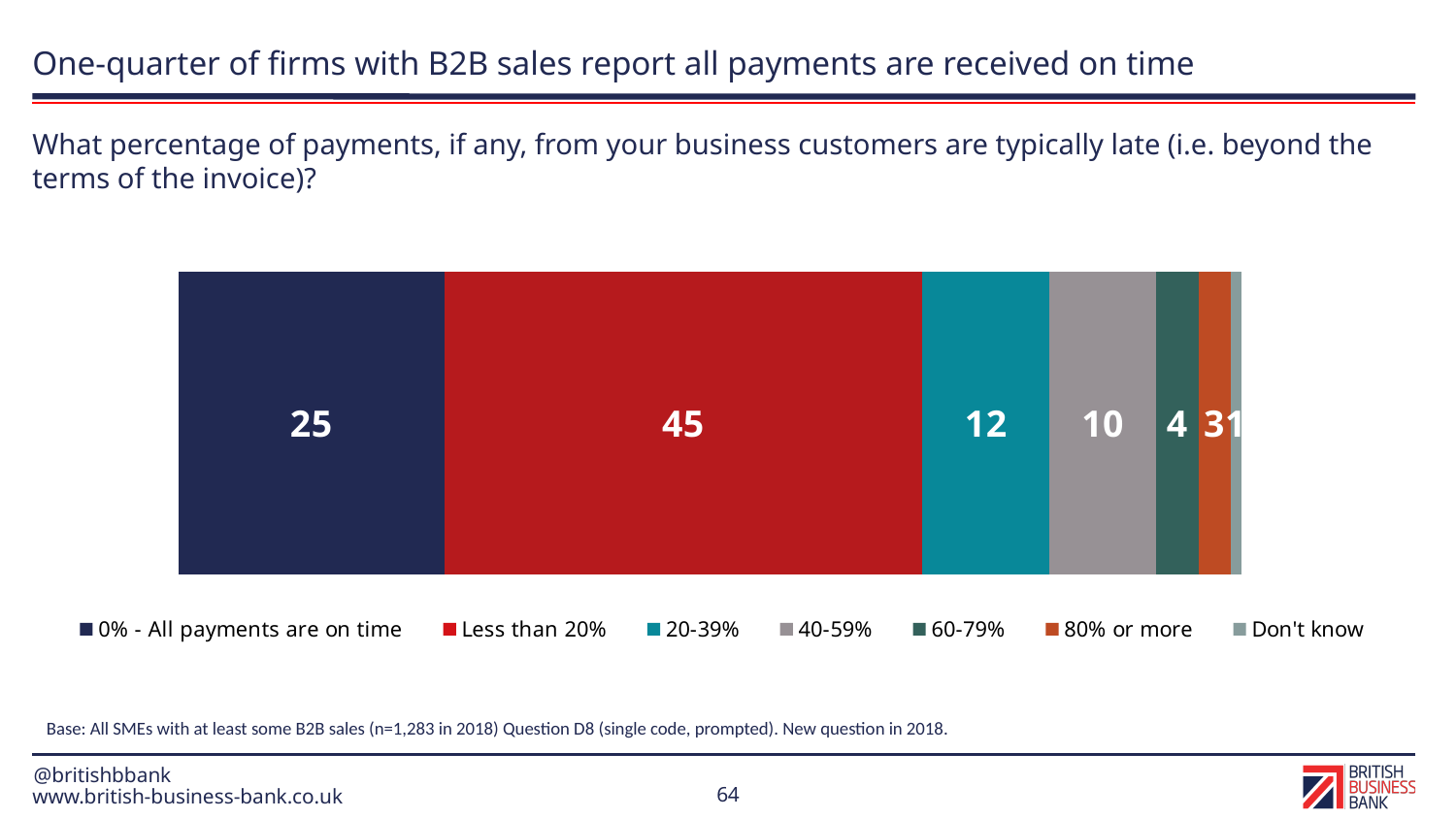
What value is shown for the '20-39%' segment? 12 Which is larger, the value for '20-39%' or the value for '40-59%'? 20-39% What colour is the 'Less than 20%' segment? Red How many segments does the legend list? 7 What is the difference between the 'Less than 20%' and '0% - All payments are on time' values? 20 What kind of chart is shown on the slide? Stacked bar chart Which segment has the highest value? Less than 20% What value is shown for the '0% - All payments are on time' segment? 25 What value is shown for the 'Less than 20%' segment? 45 What value is shown for the '40-59%' segment? 10 What is the total of all the segments in the stacked bar? 100 What value is shown for the '60-79%' segment? 4